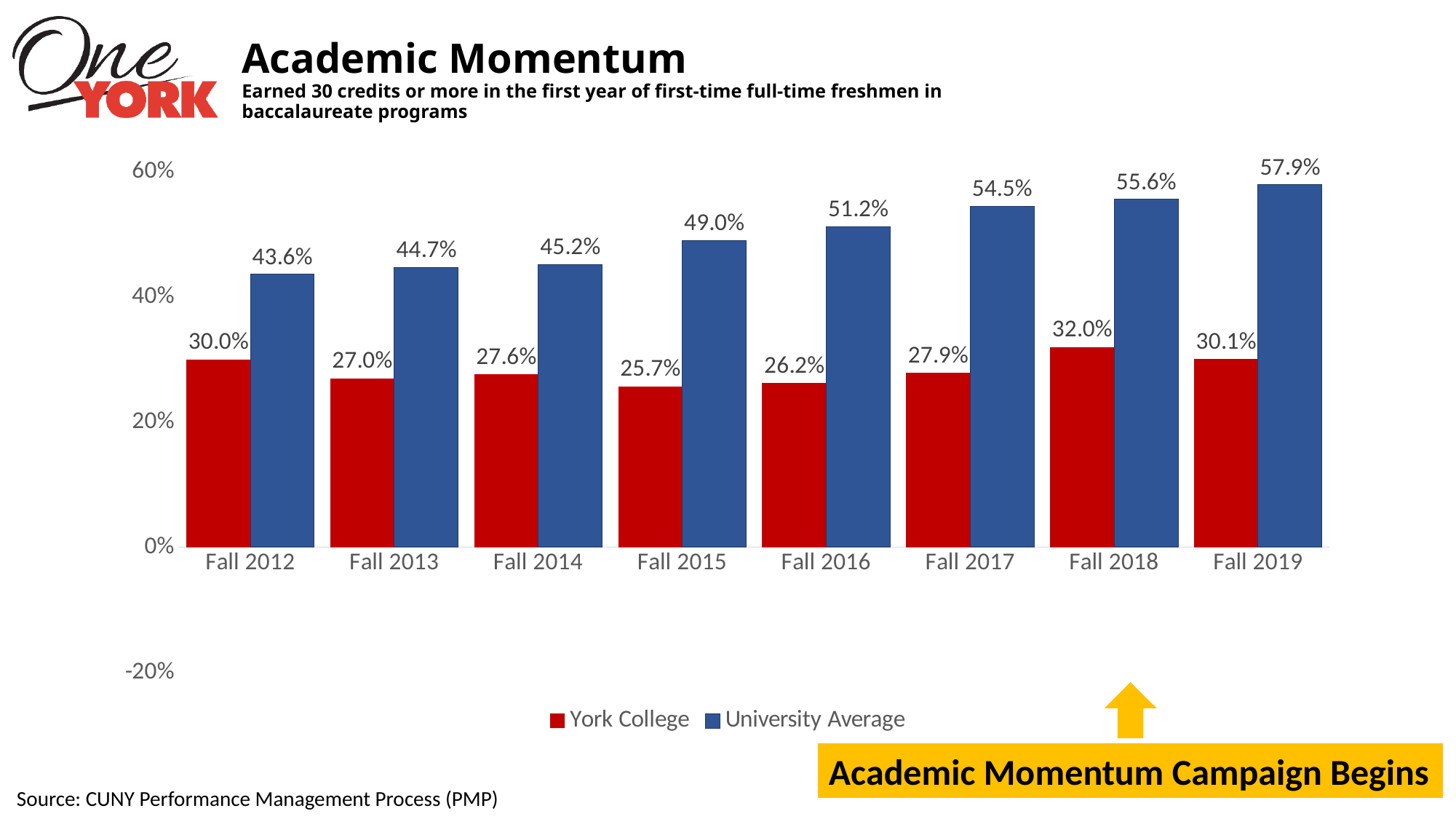
How many terms are shown on the x axis? 8 What is the University Average value for Fall 2015? 49.0% What colour are the York College bars? Red In which term is the York College value lowest? Fall 2015 Does the University Average value rise or fall from Fall 2012 to Fall 2019? Rise What is the York College value for Fall 2018? 32.0% In which term is the University Average value highest? Fall 2019 What is the difference between the University Average and York College values in Fall 2019? 27.8% In which term is the York College value highest? Fall 2018 What kind of chart is shown on the slide? Bar chart How many series does the legend list? 2 Which is larger in Fall 2012: the York College value or the University Average value? University Average